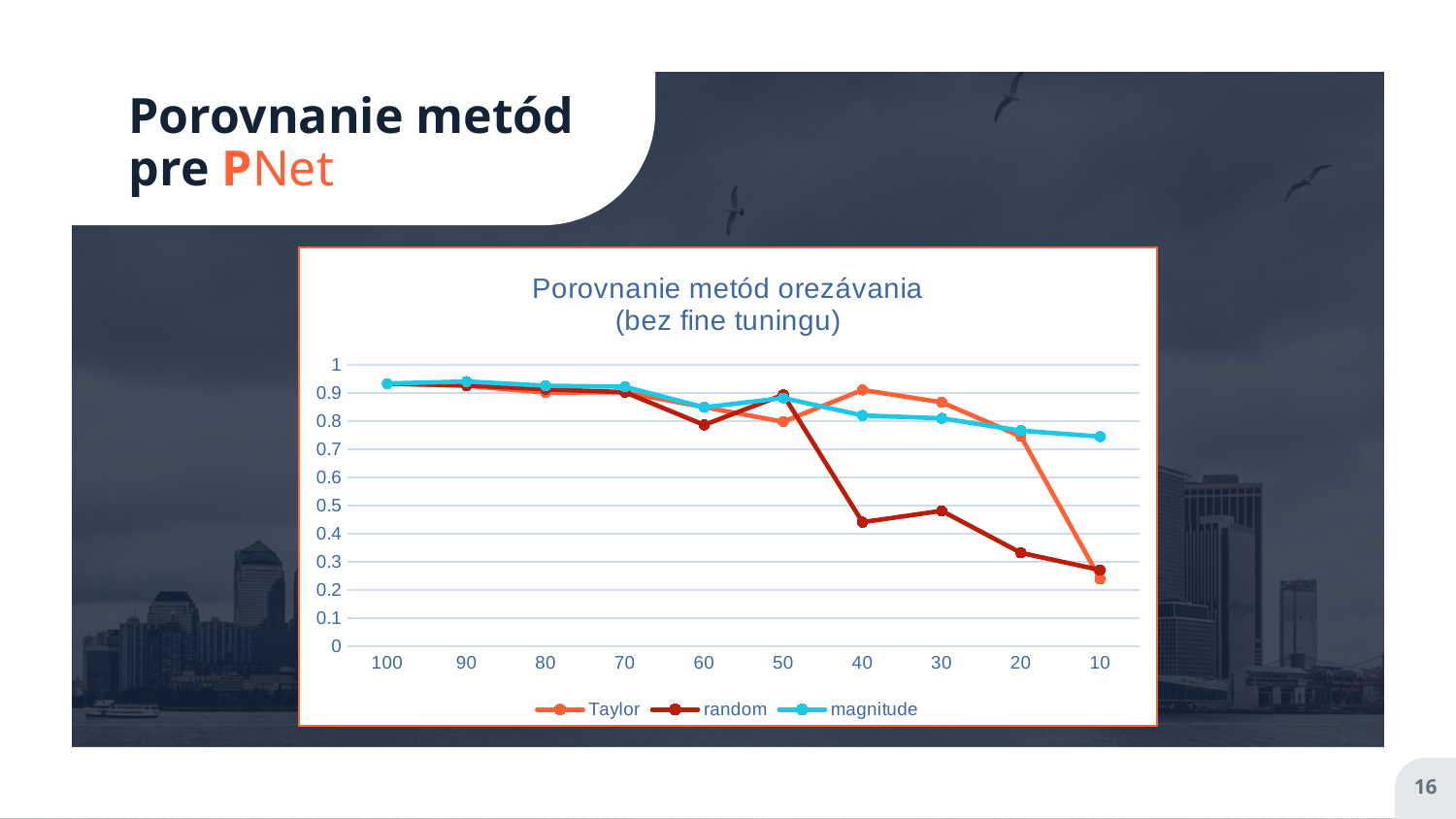
Is the value for Taylor at 50 greater or less than 0.9? less How many points are there along the x axis? 10 Is the value for random at 40 greater or less than 0.5? less Is the value for Taylor at 10 greater or less than 0.3? less What is the title of the chart? Porovnanie metód orezávania (bez fine tuningu) How many series does the legend list? 3 Which series has the lowest value at 20? random Do the values for magnitude rise or fall moving from 100 to 10 along the x axis? fall What kind of chart is shown on the slide? line chart At 40, which series has the larger value, Taylor or random? Taylor At 10, which series has the larger value, magnitude or Taylor? magnitude